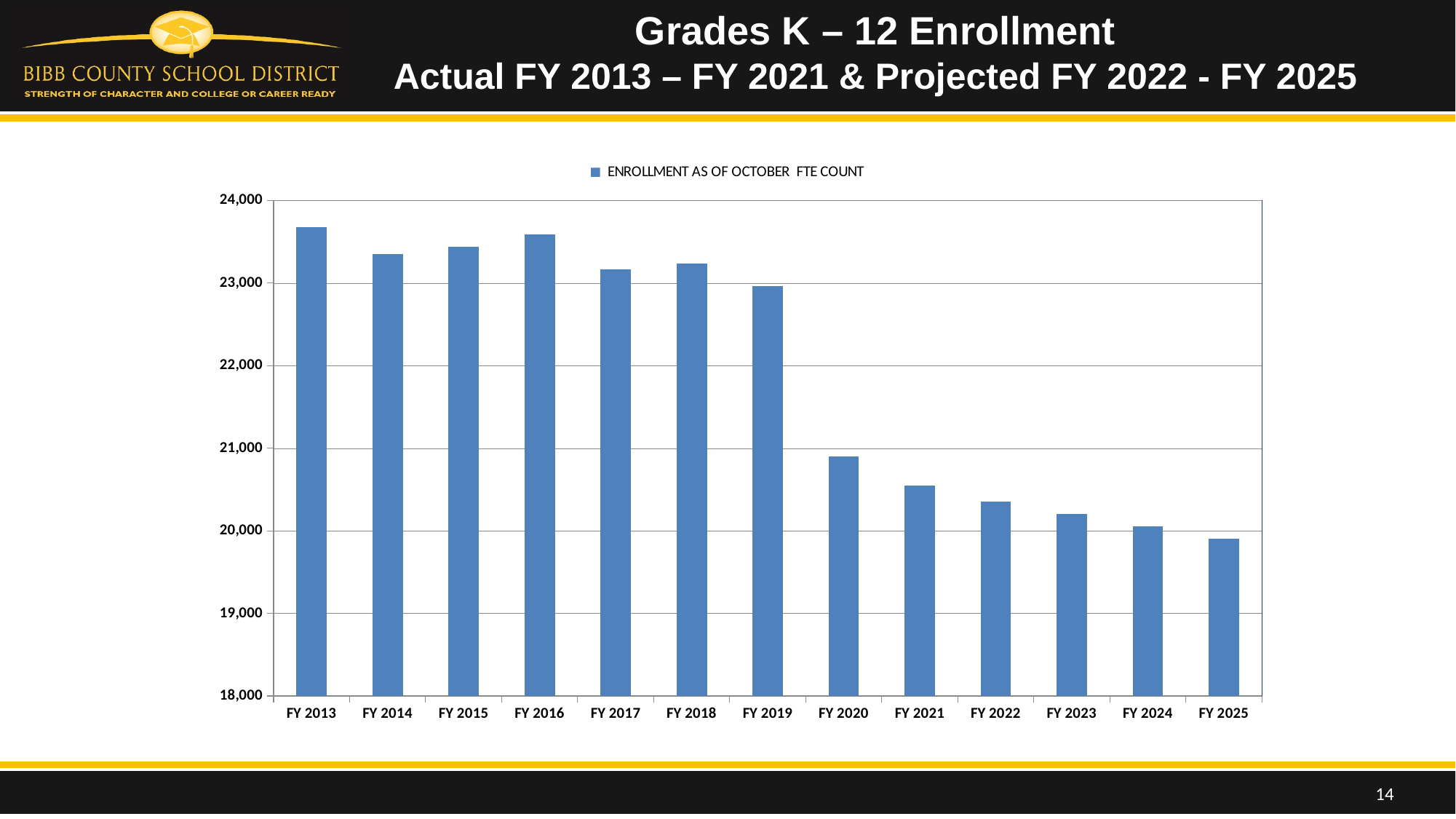
Do enrollment values generally rise or fall from FY 2013 to FY 2025? fall Which is larger, the enrollment for FY 2013 or for FY 2020? FY 2013 What is the legend entry for the plotted series? ENROLLMENT AS OF OCTOBER FTE COUNT Which is larger, the enrollment for FY 2018 or for FY 2019? FY 2018 Is the enrollment for FY 2022 greater or less than 21,000? less Is the enrollment for FY 2017 greater or less than 23,000? greater What kind of chart is shown on the slide? bar chart Which fiscal year has the lowest enrollment? FY 2025 How many fiscal years are plotted on the x axis? 13 Is the enrollment for FY 2013 greater or less than 23,000? greater How many series does the legend list? 1